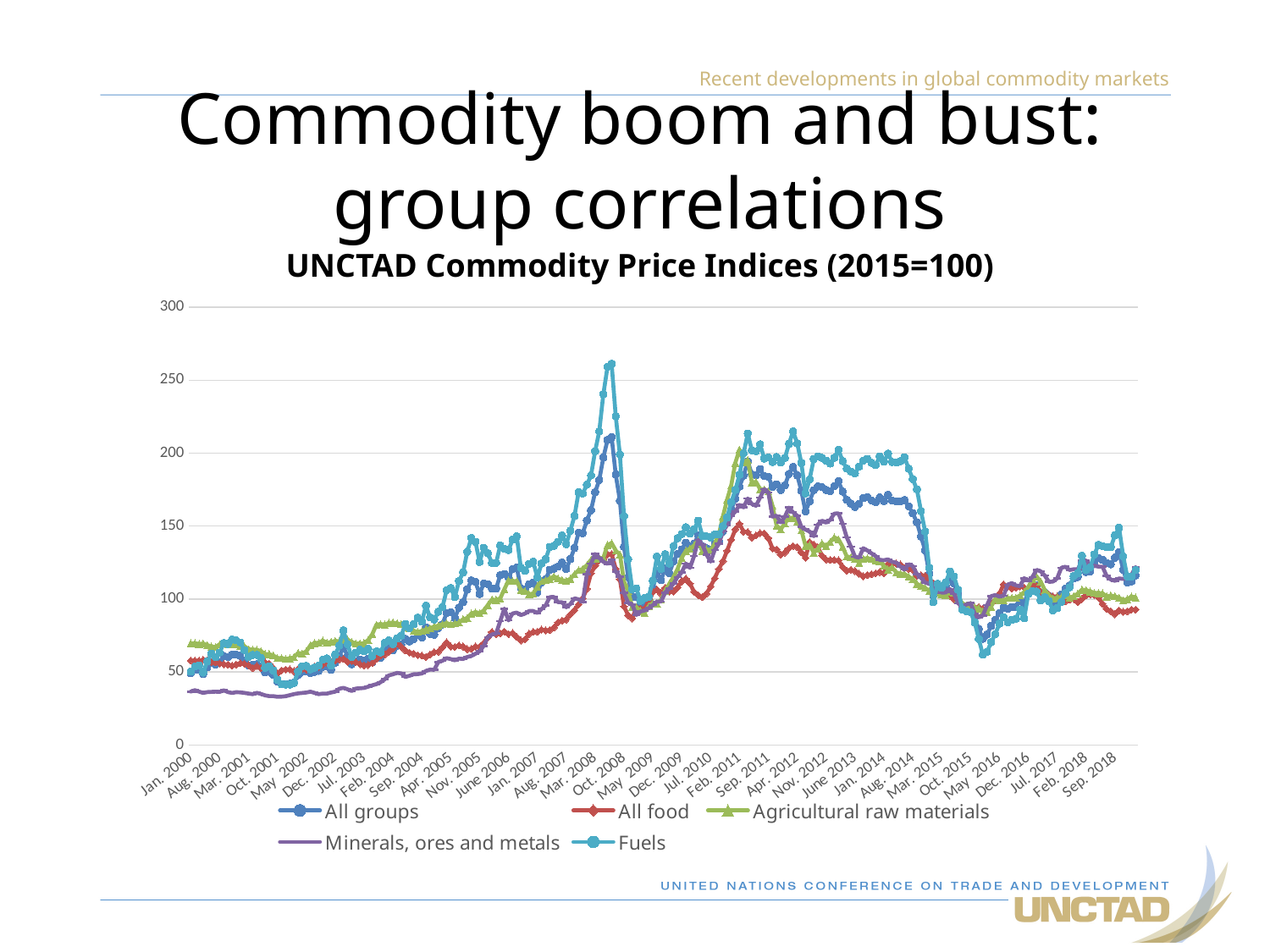
At the 2008 peak, which is larger: the Fuels series or the All food series? Fuels How many series does the legend list? 5 What is the title of the chart? UNCTAD Commodity Price Indices (2015=100) Which series reaches the highest peak on the chart? Fuels Does the All groups series rise or fall between its 2011 peak and early 2016? Fall Which series has the lowest value at the start of the chart (Jan. 2000)? Minerals, ores and metals Does the Fuels series rise or fall between Jan. 2000 and its peak in 2008? Rise Is the peak value of the Fuels series in 2008 greater or less than 250? greater What kind of chart is shown on the slide? Line chart What colour is the All food series in the legend? Red Is the value for Minerals, ores and metals in Jan. 2000 greater or less than 50? less Is the highest value reached by the All food series greater or less than 200? less